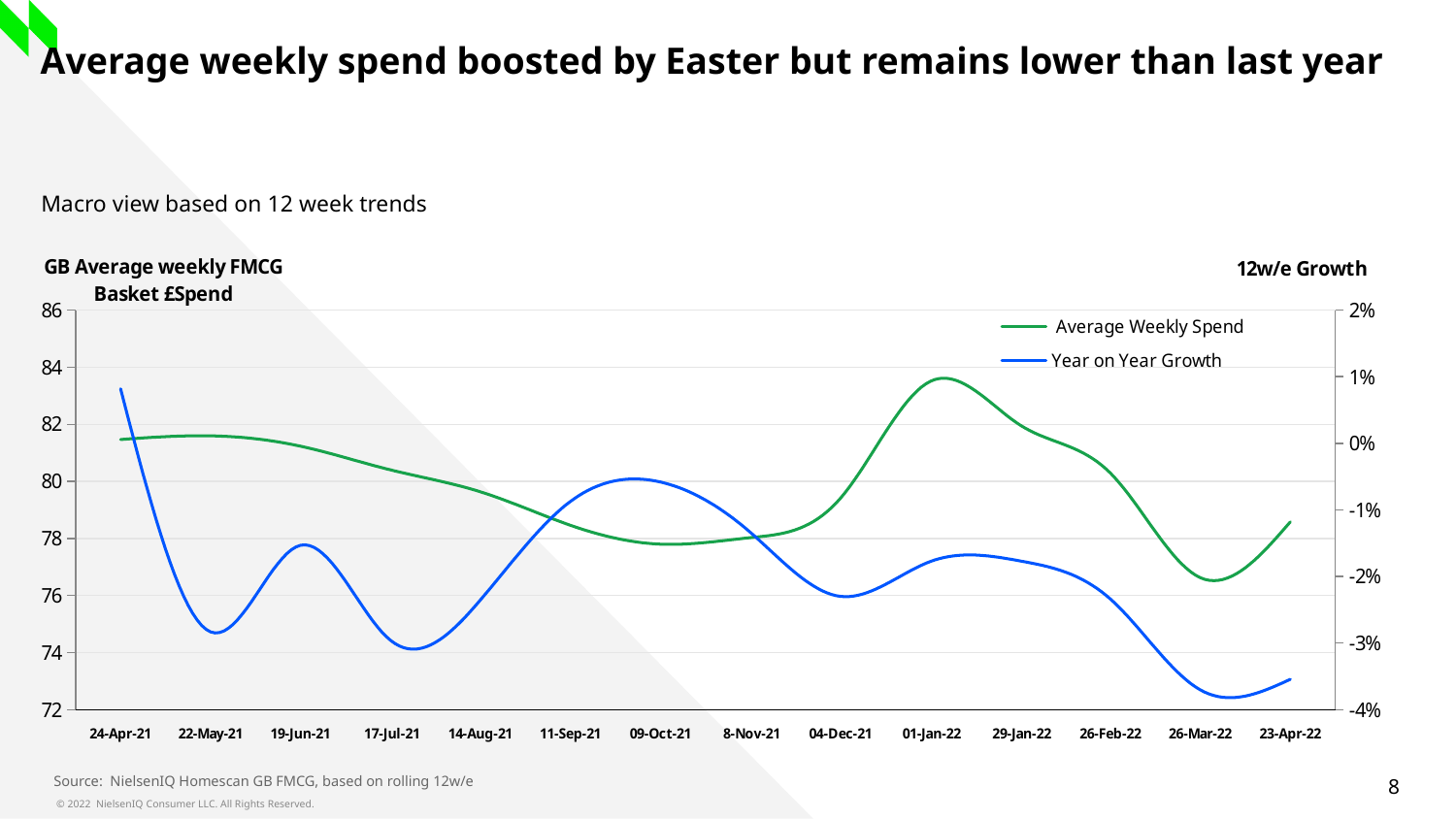
Is the Year on Year Growth value at 24-Apr-21 greater or less than 0%? greater At which date is the Year on Year Growth line at its highest? 24-Apr-21 Is the Average Weekly Spend value at 01-Jan-22 greater or less than 82? greater How many dates are labelled along the x axis? 14 Is the Year on Year Growth value at 23-Apr-22 greater or less than -3%? less What kind of chart is shown on the slide? Line chart At which date is the Year on Year Growth line at its lowest? 26-Mar-22 At which date does the Average Weekly Spend line reach its lowest point? 26-Mar-22 Which is higher: the Average Weekly Spend at 24-Apr-21 or at 23-Apr-22? 24-Apr-21 At which date does the Average Weekly Spend line reach its highest point? 01-Jan-22 How many series does the legend list? 2